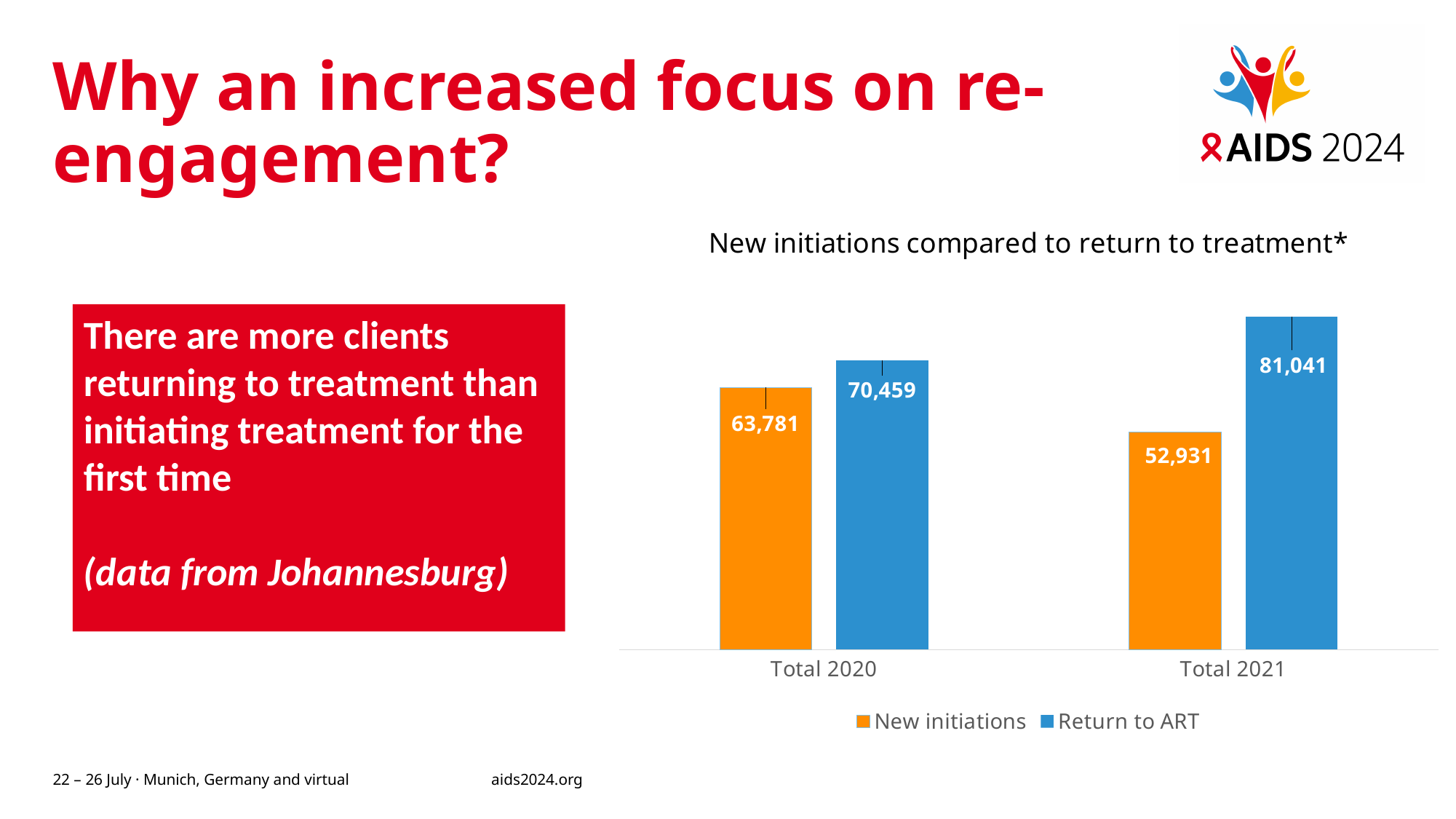
Which is larger in Total 2020: New initiations or Return to ART? Return to ART What is the difference between Return to ART and New initiations in Total 2021? 28,110 Which bar has the highest value on the chart? Return to ART, Total 2021 What is the value for New initiations in Total 2021? 52,931 What is the difference between Return to ART and New initiations in Total 2020? 6,678 Which bar has the lowest value on the chart? New initiations, Total 2021 What is the value for New initiations in Total 2020? 63,781 Do the New initiations values rise or fall from Total 2020 to Total 2021? Fall What is the value for Return to ART in Total 2020? 70,459 What is the value for Return to ART in Total 2021? 81,041 What kind of chart is shown on the slide? Bar chart How many series does the legend list? 2